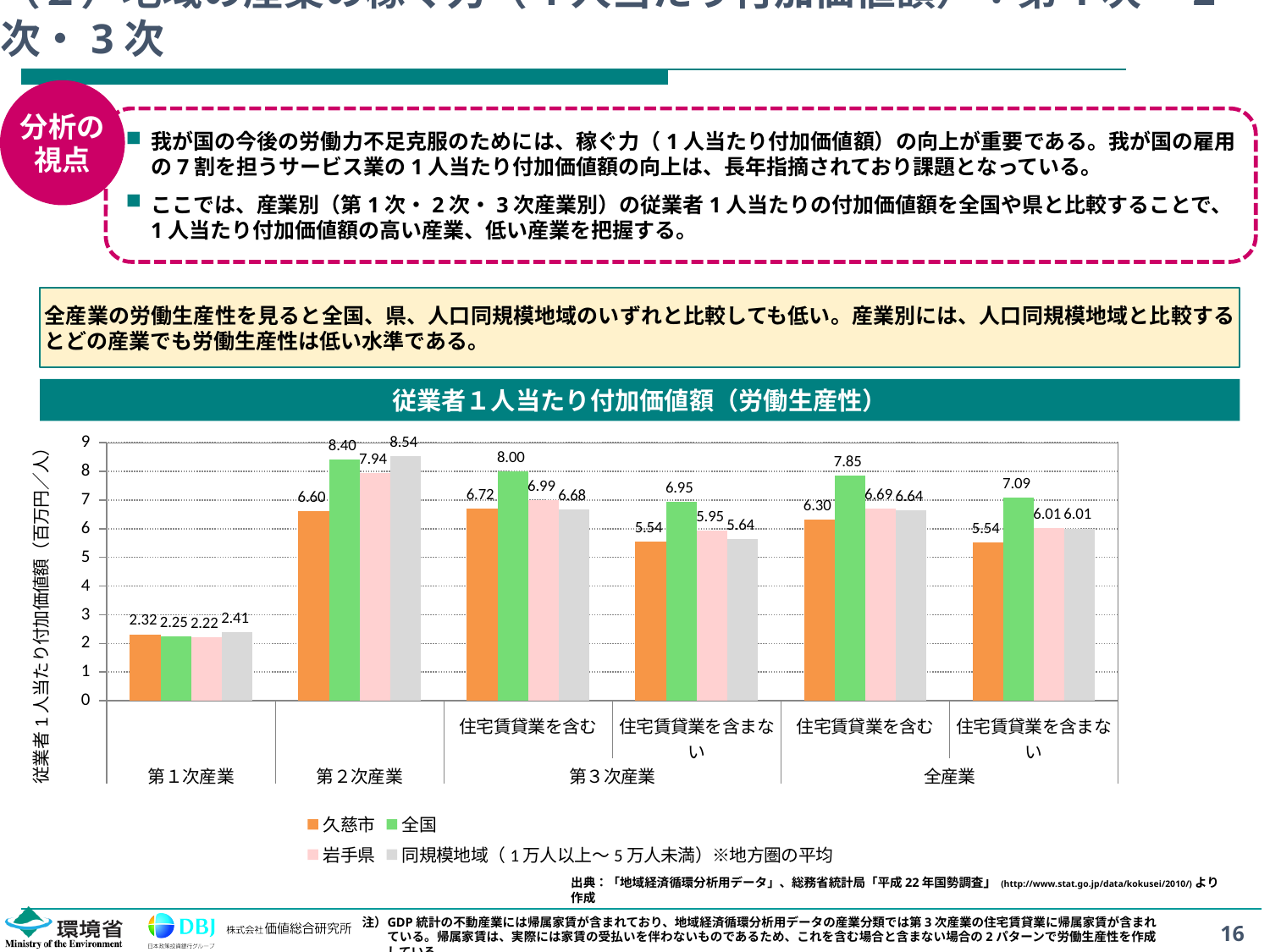
Which series has the highest value in 第２次産業? 同規模地域（１万人以上～５万人未満）※地方圏の平均 Is the value for 全国 in 全産業（住宅賃貸業を含む） greater or less than 7? greater What is the value for 久慈市 in 第２次産業? 6.60 What is the value for 同規模地域 in 全産業（住宅賃貸業を含まない）? 6.01 Which series has the lowest value in 全産業（住宅賃貸業を含む）? 久慈市 Which is larger in 第３次産業（住宅賃貸業を含まない）: 岩手県 or 同規模地域? 岩手県 What is the difference between 全国 and 久慈市 in 第２次産業? 1.80 What is the value for 岩手県 in 第１次産業? 2.22 What is the unit shown on the y-axis? 百万円／人 What kind of chart is shown? bar chart What is the value for 全国 in 第３次産業（住宅賃貸業を含む）? 8.00 How many series does the legend list? 4